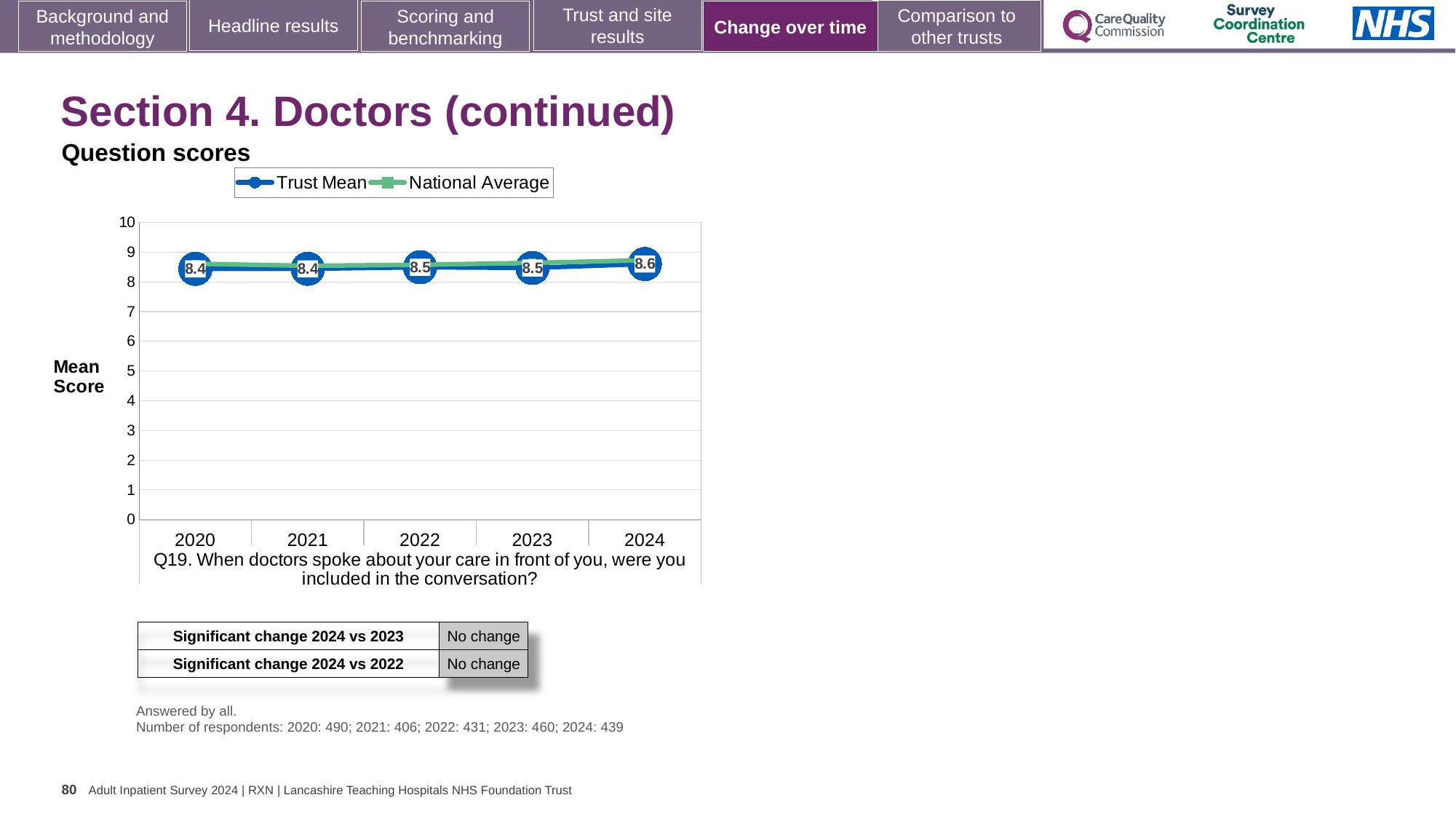
Does the Trust Mean score rise or fall from 2020 to 2024? Rise What is the Trust Mean score for 2022? 8.5 What are the two series named in the legend? Trust Mean and National Average How many series does the legend list? 2 Is the Trust Mean score for 2023 larger than the Trust Mean score for 2021? Yes, 2023 (8.5) is larger than 2021 (8.4) What is the difference between the Trust Mean score in 2024 and in 2020? 0.2 What is the Trust Mean score for 2024? 8.6 Is the National Average value for 2024 greater or less than 8? greater What is the Trust Mean score for 2020? 8.4 How many years are plotted on the x axis? 5 What kind of chart is shown on the slide? Line chart In which year is the Trust Mean score highest? 2024